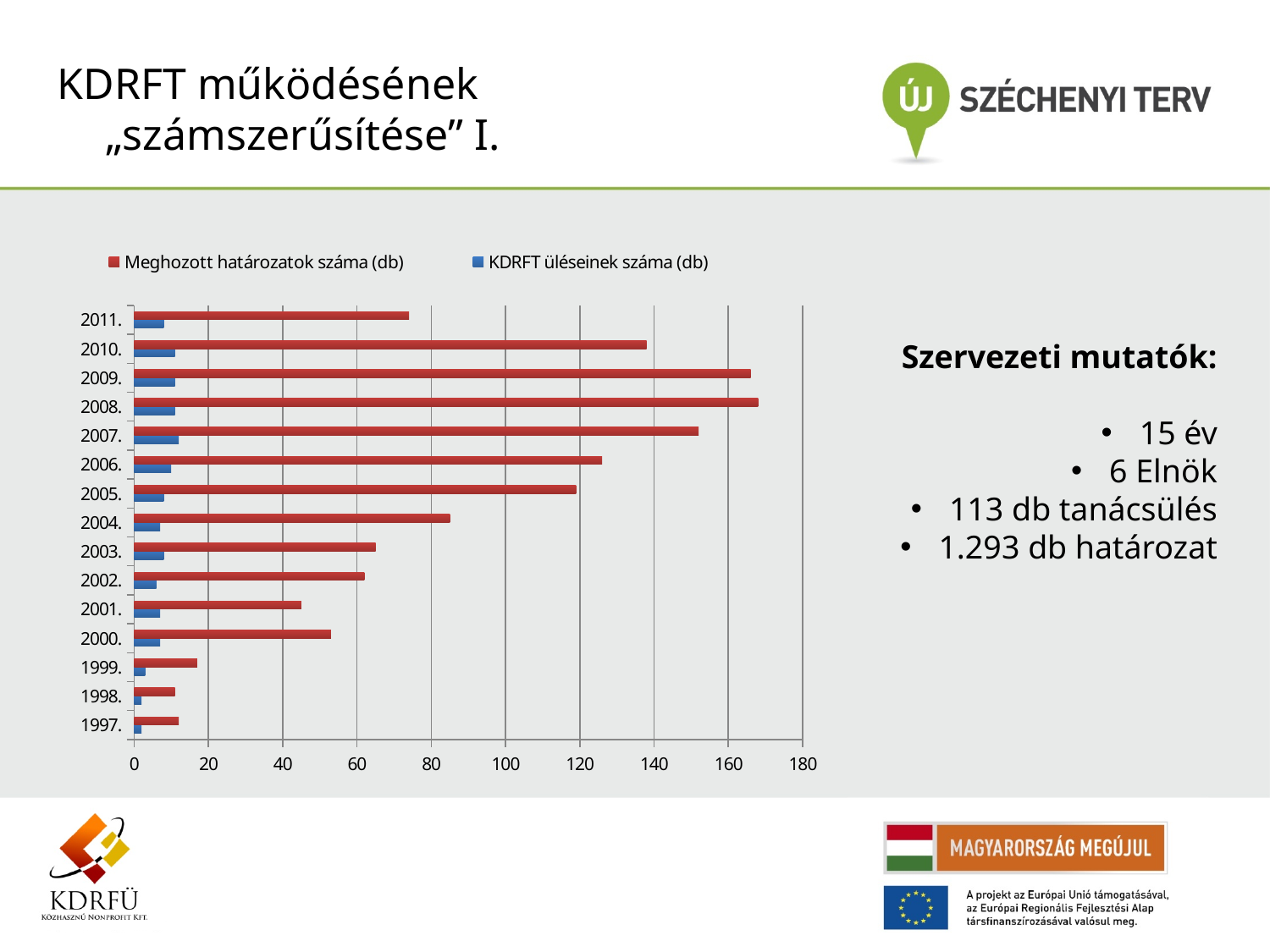
Is the value of KDRFT üléseinek száma (db) for 2007 greater or less than 20? less Is the value of Meghozott határozatok száma (db) for 2011 greater or less than 80? less Which series is drawn in red in the chart? Meghozott határozatok száma (db) How many series does the chart legend list? 2 Is the value of Meghozott határozatok száma (db) for 2001 greater or less than 60? less How many years are shown on the vertical axis of the chart? 15 What kind of chart is shown on the slide? bar chart Which year has the larger value of KDRFT üléseinek száma (db), 1998 or 2007? 2007 Which year has the larger value of Meghozott határozatok száma (db), 2010 or 2011? 2010 Which year has the larger value of Meghozott határozatok száma (db), 2004 or 2005? 2005